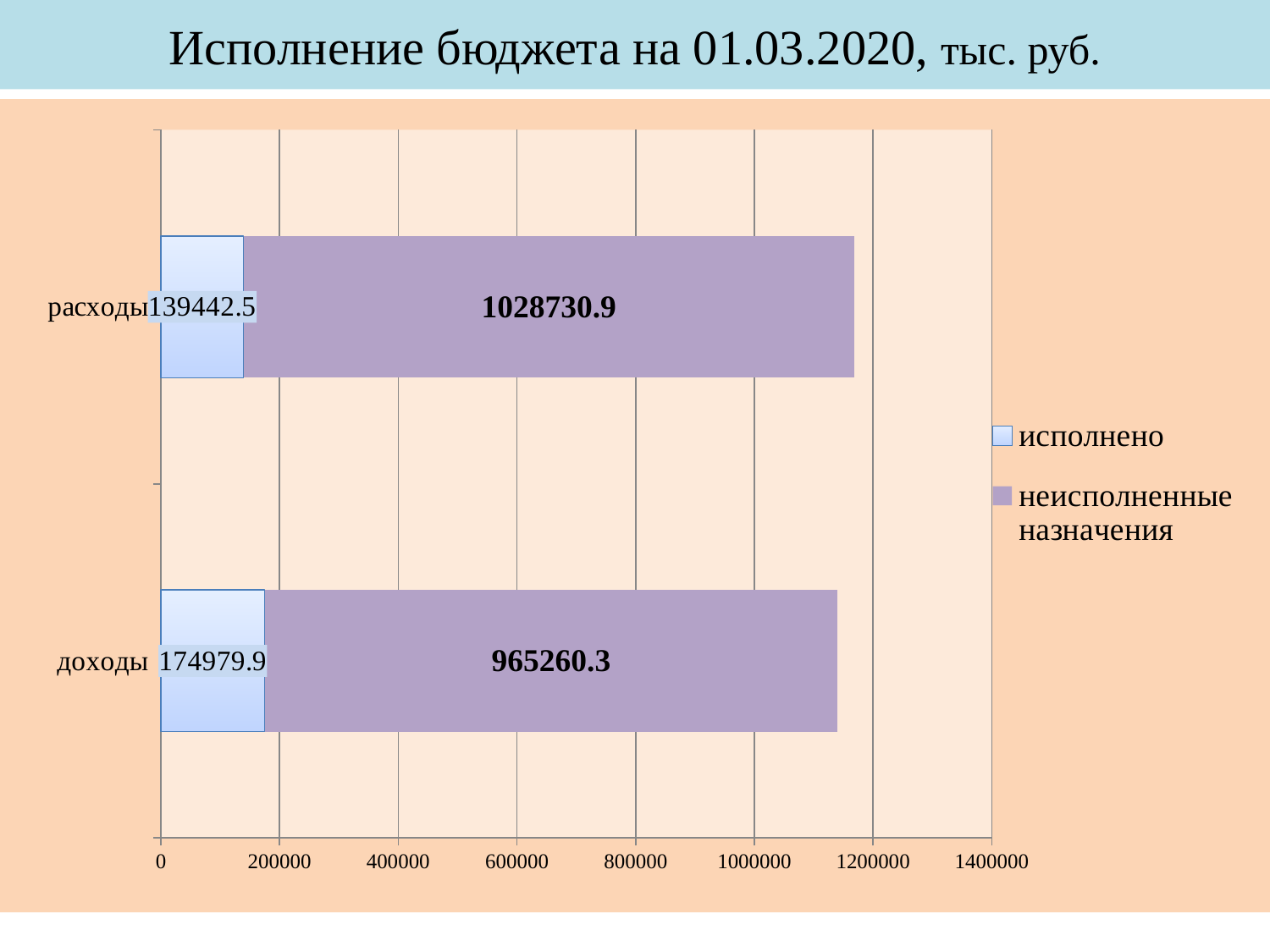
What is the total of the stacked bar for "доходы"? 1140240.2 Which category has the higher "неисполненные назначения" value? расходы What is the difference between the "исполнено" values for "доходы" and "расходы"? 35537.4 What is the value of "исполнено" for "доходы"? 174979.9 Which category has the higher "исполнено" value, "расходы" or "доходы"? доходы What type of chart is shown on the slide? Stacked bar chart What is the value of "исполнено" for "расходы"? 139442.5 What is the difference between the "неисполненные назначения" values for "расходы" and "доходы"? 63470.6 How many series does the legend list? 2 What is the value of "неисполненные назначения" for "расходы"? 1028730.9 What is the total of the stacked bar for "расходы"? 1168173.4 What is the value of "неисполненные назначения" for "доходы"? 965260.3